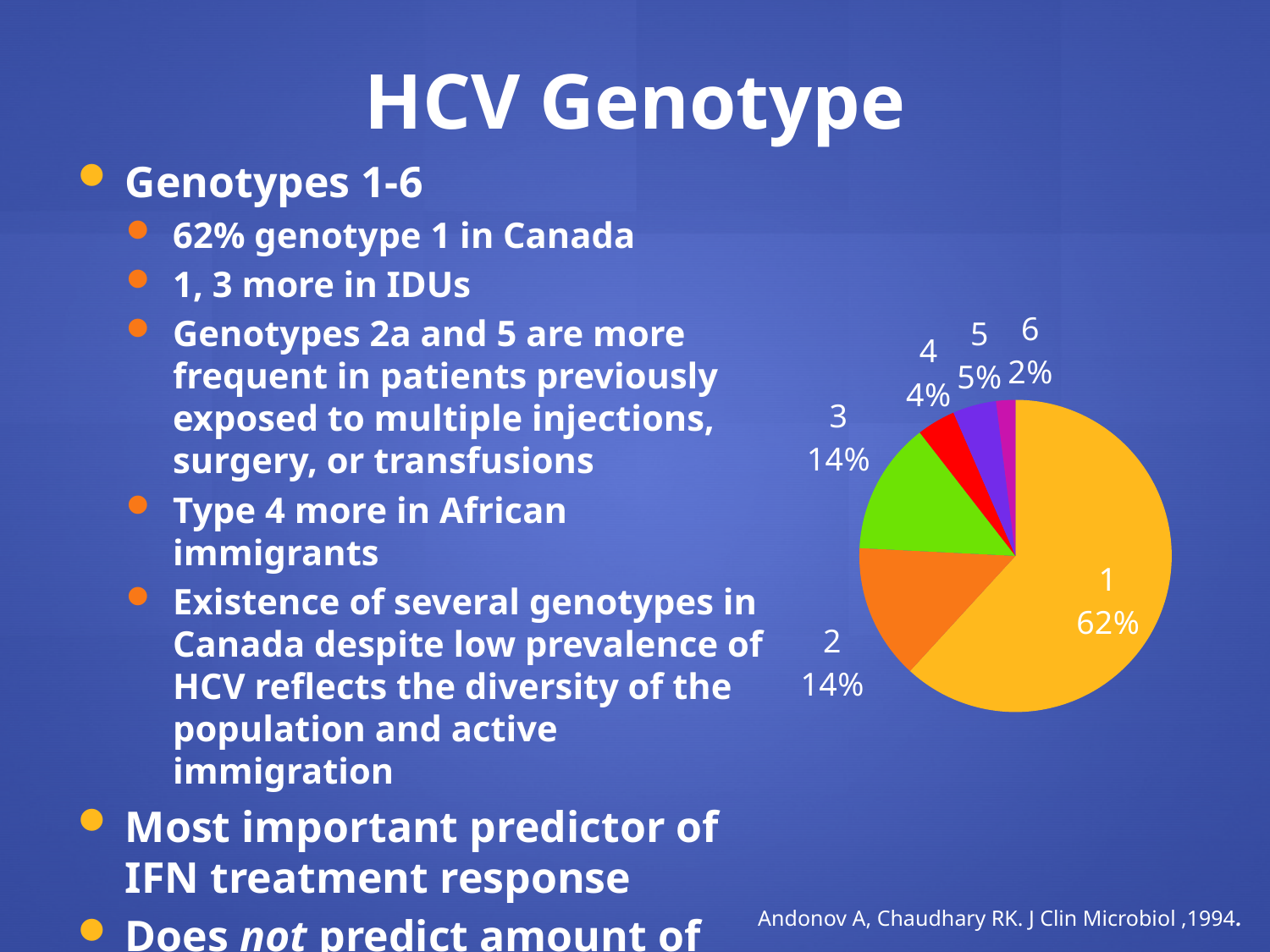
Which genotype has the smallest slice of the pie chart? 6 What type of chart is shown on the slide? Pie chart What share of the pie does genotype 1 represent? 62% What colour is the slice for genotype 3 in the pie chart? Green Which is larger in the pie chart, the share for genotype 5 or genotype 4? Genotype 5 What percentage is shown for genotype 5 in the pie chart? 5% What percentage is shown for genotype 3 in the pie chart? 14% What percentage is shown for genotype 6 in the pie chart? 2% What percentage is shown for genotype 4 in the pie chart? 4% How many slices does the pie chart have? 6 Which genotype has the largest slice of the pie chart? 1 What is the difference in percentage points between genotype 1 and genotype 2? 48%